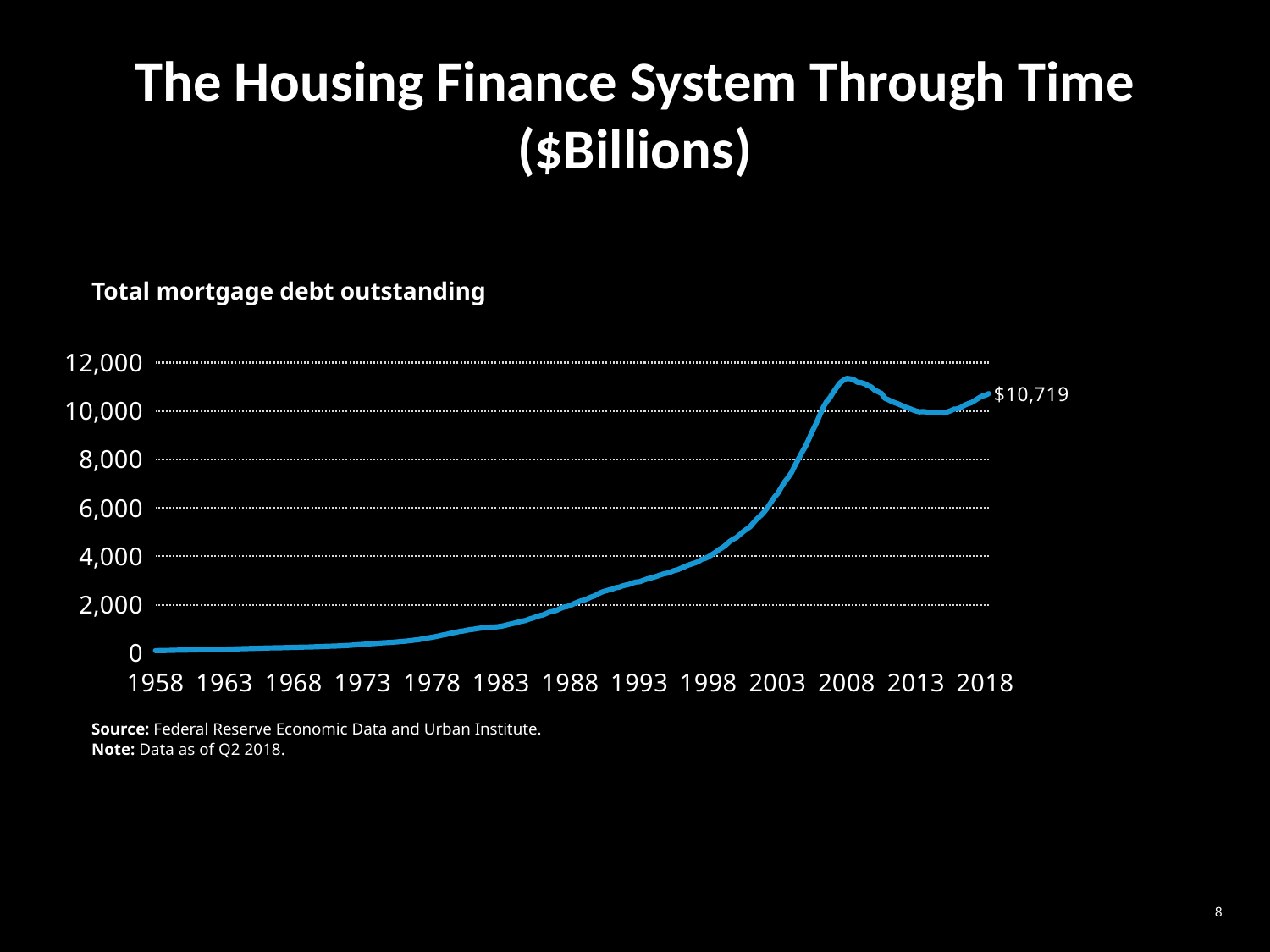
Around which year labelled on the x axis does the line reach its highest point? 2008 Which year labelled on the x axis has the lowest value? 1958 What is the subtitle of the chart? Total mortgage debt outstanding Is the value for 2008 greater or less than 10,000? greater How many year labels are shown on the x axis? 13 Is the value for 2013 greater or less than 8,000? greater What is the value of total mortgage debt outstanding at the end of the line (2018)? $10,719 Does total mortgage debt outstanding generally rise or fall from 1958 to 2018? rise What kind of chart is shown on the slide? line chart Is the value for 1978 greater or less than 2,000? less Is the value for 2008 larger or smaller than the value for 2018? larger